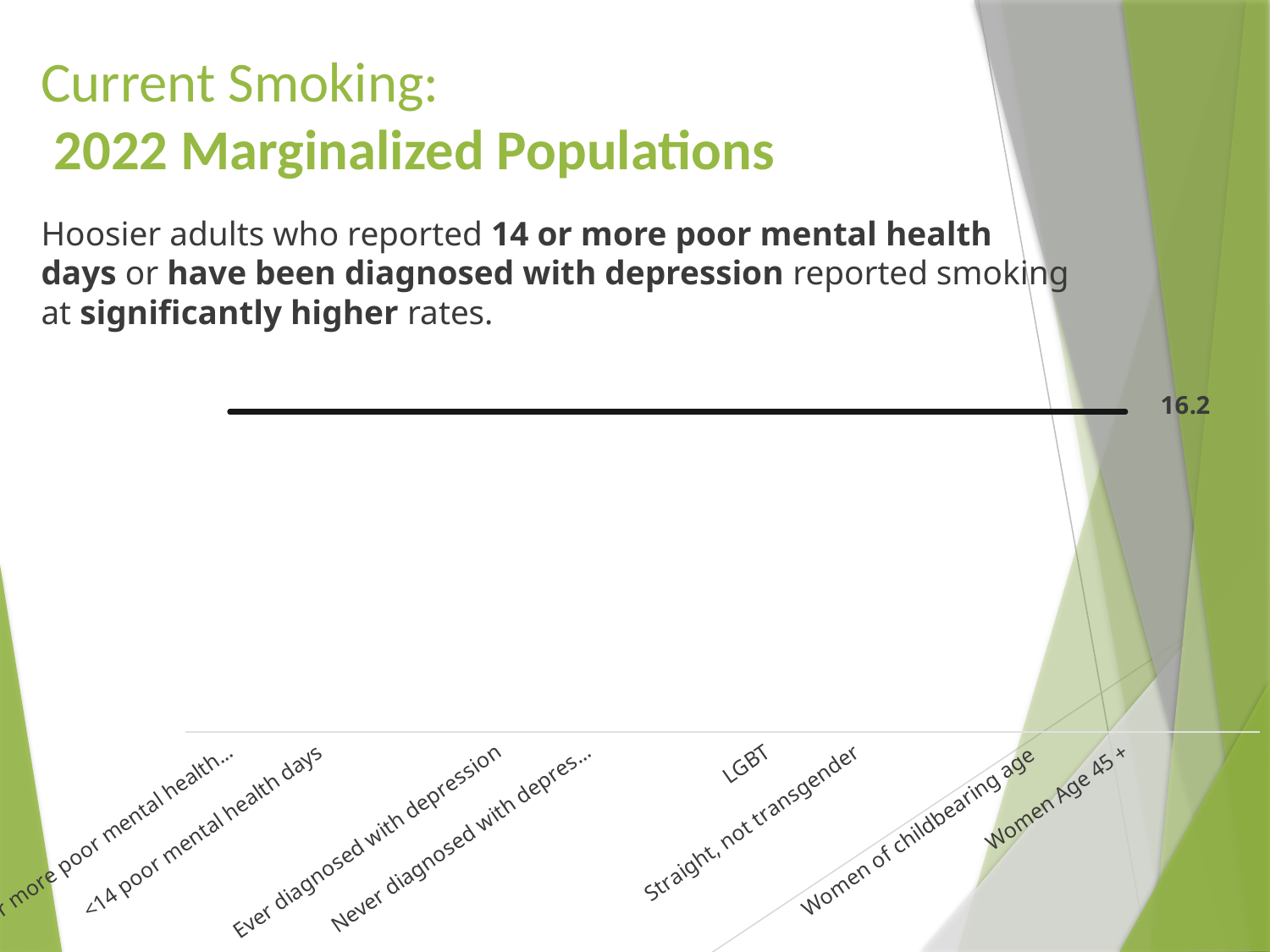
What value is printed at the right end of the horizontal reference line on the chart? 16.2 Which category label appears furthest to the right on the chart's x axis? Women Age 45 + How many categories are labeled along the x axis of the chart? 8 Which category label appears immediately to the left of "Straight, not transgender" on the chart's x axis? LGBT